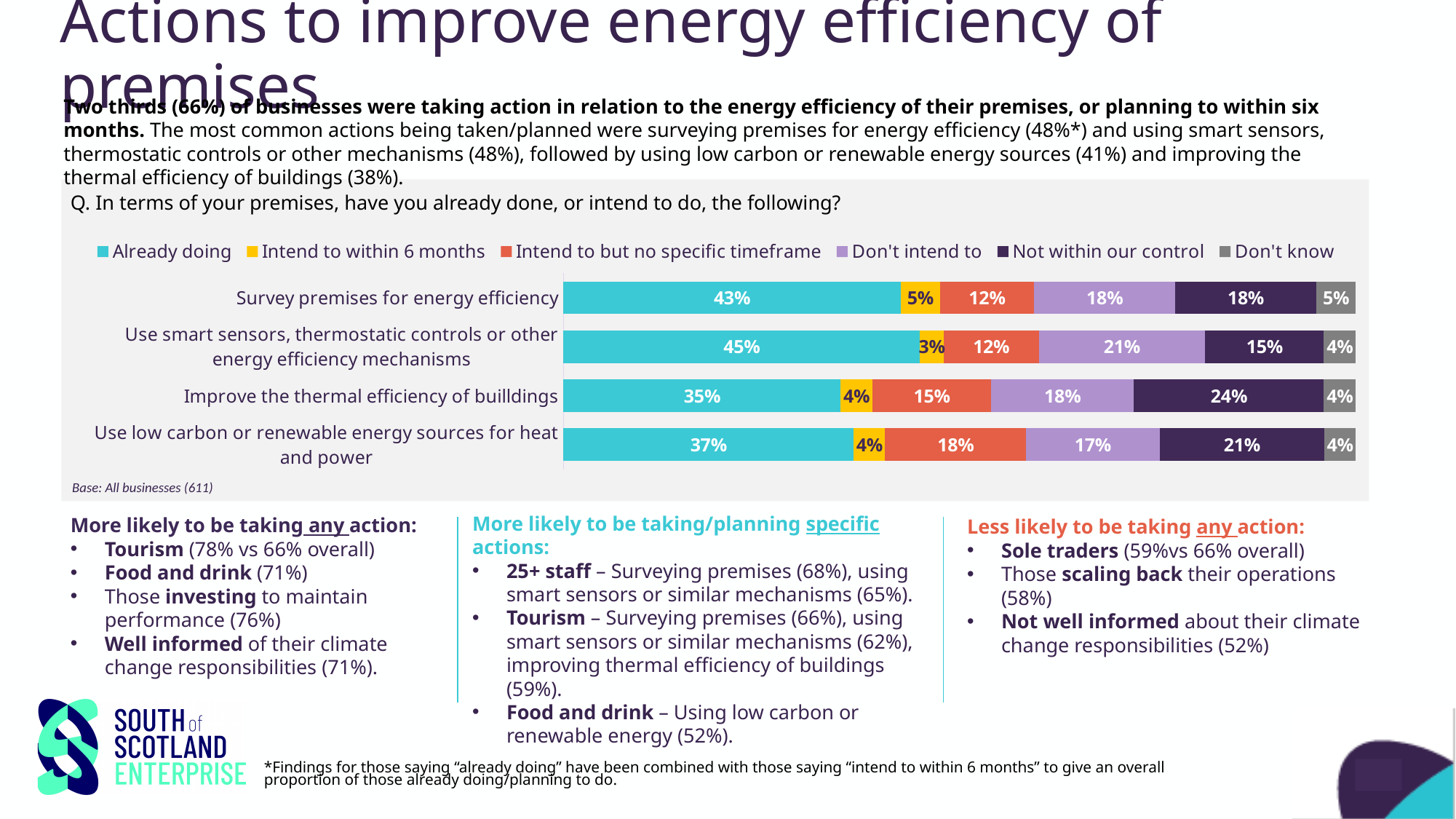
What kind of chart is shown on the slide? Stacked bar chart How many series does the legend list? 6 What is the 'Intend to but no specific timeframe' value for 'Use low carbon or renewable energy sources for heat and power'? 18% Which is larger: the 'Not within our control' value for 'Survey premises for energy efficiency' or for 'Use low carbon or renewable energy sources for heat and power'? Use low carbon or renewable energy sources for heat and power What percentage of businesses are 'Already doing' a survey of premises for energy efficiency? 43% What is the 'Not within our control' value for 'Improve the thermal efficiency of buildings'? 24% How many categories (actions) are plotted in the chart? 4 What is the 'Don't intend to' value for 'Use smart sensors, thermostatic controls or other energy efficiency mechanisms'? 21% Which action has the highest 'Already doing' percentage? Use smart sensors, thermostatic controls or other energy efficiency mechanisms Which legend entry is shown in yellow? Intend to within 6 months Which action has the lowest 'Already doing' percentage? Improve the thermal efficiency of buildings What is the difference between the 'Already doing' values for 'Survey premises for energy efficiency' and 'Improve the thermal efficiency of buildings'? 8 percentage points